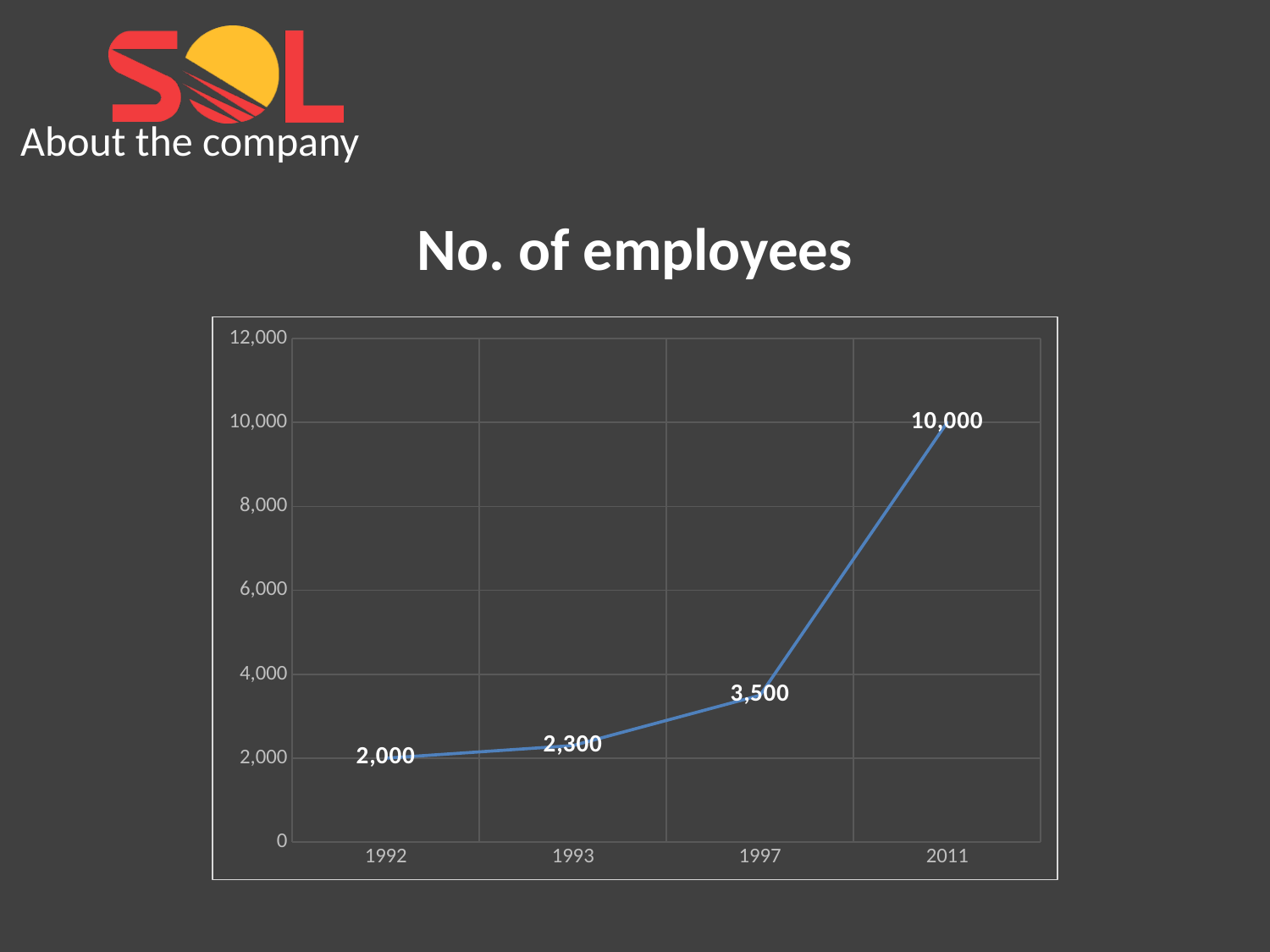
What is the difference in the number of employees between 2011 and 1997? 6,500 What is the difference in the number of employees between 1993 and 1992? 300 Which year has the lowest number of employees? 1992 Which year has more employees, 1997 or 1993? 1997 What is the number of employees in 1997? 3,500 What is the number of employees in 2011? 10,000 How many years are plotted on the chart? 4 What is the number of employees in 1992? 2,000 What kind of chart is shown on the slide? Line chart Which year has the highest number of employees? 2011 Does the number of employees rise or fall from 1992 to 2011? Rise What is the number of employees in 1993? 2,300